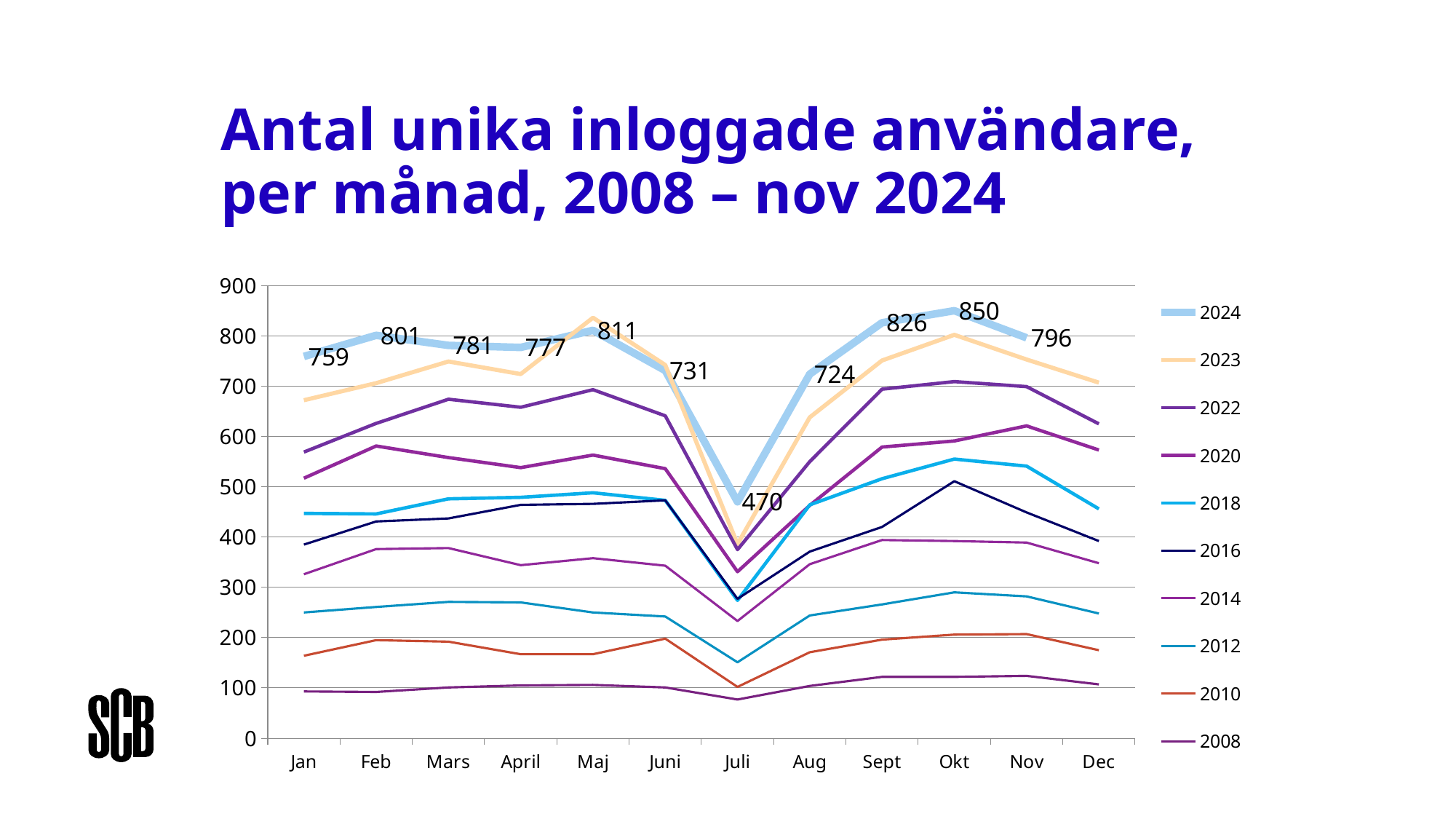
What is the difference between the 2024 values for Okt and Nov? 54 What is the title of the chart? Antal unika inloggade användare, per månad, 2008 – nov 2024 In which month does the 2024 series reach its highest value? Okt What is the value for 2024 in Jan? 759 Is the value for 2008 in Juli greater or less than 100? less How many months are shown on the x axis? 12 In which month does the 2024 series have its lowest value? Juli What is the value for 2024 in Juli? 470 What type of chart is shown on the slide? line chart Which is larger for 2024: the value in Feb or the value in Mars? Feb What is the value for 2024 in Okt? 850 How many series does the legend list? 10